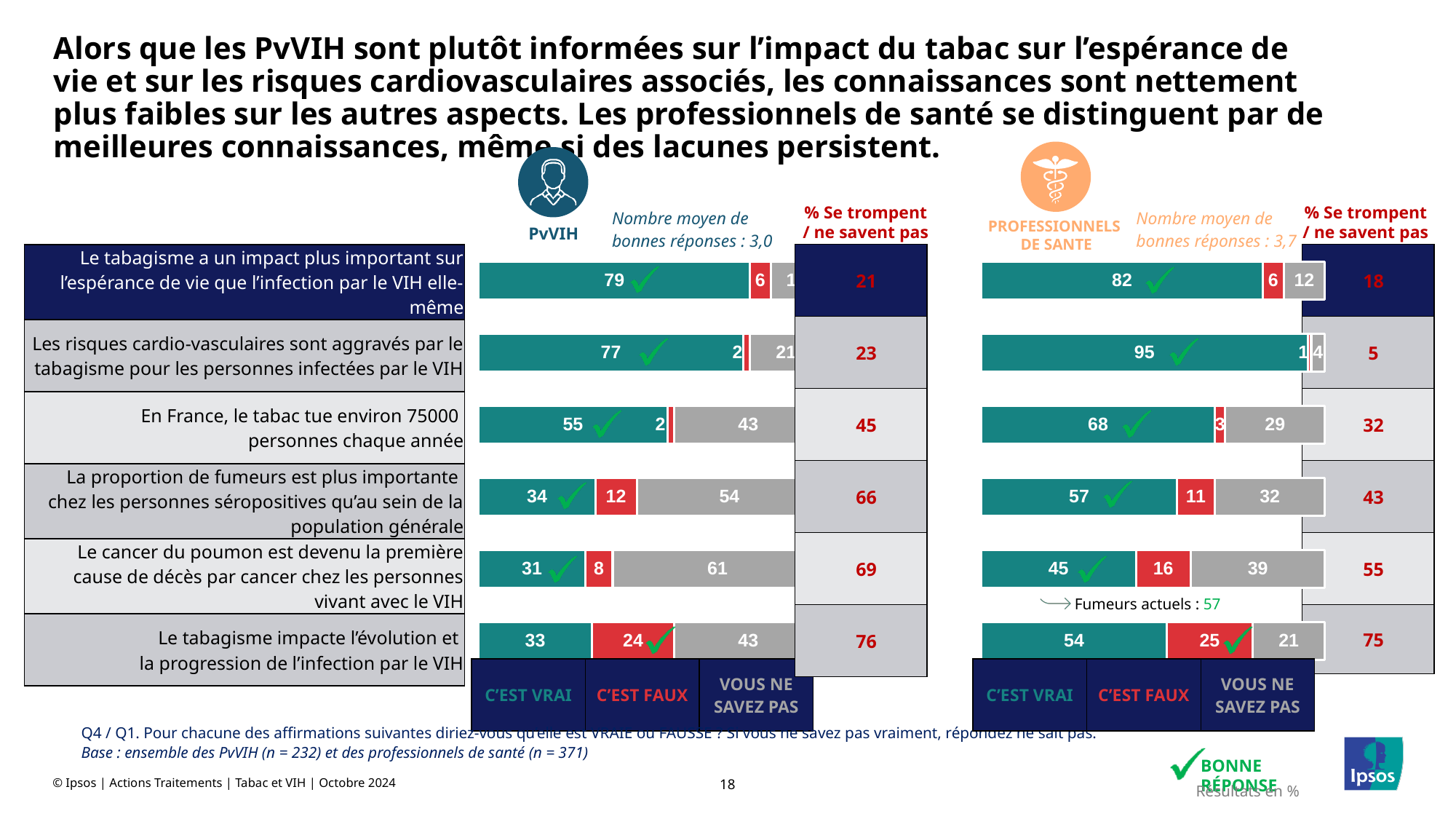
In the PvVIH chart, what is the total of the three segments for "La proportion de fumeurs est plus importante chez les personnes séropositives qu'au sein de la population générale"? 100 How many statements are shown in each chart? 6 What is the "Nombre moyen de bonnes réponses" for the Professionnels de santé? 3,7 What type of chart is used to show the responses? Stacked bar chart In the PvVIH chart, which statement has the lowest "C'est vrai" percentage? Le cancer du poumon est devenu la première cause de décès par cancer chez les personnes vivant avec le VIH How many response categories does the legend list for each chart? 3 What is the difference between the "C'est vrai" percentages for "La proportion de fumeurs est plus importante chez les personnes séropositives qu'au sein de la population générale" in the Professionnels de santé chart and in the PvVIH chart? 23 For "Le cancer du poumon est devenu la première cause de décès par cancer chez les personnes vivant avec le VIH", which group has the larger "Vous ne savez pas" percentage, PvVIH or Professionnels de santé? PvVIH In the PvVIH chart, what is the "% Se trompent / ne savent pas" value for "Le tabagisme impacte l'évolution et la progression de l'infection par le VIH"? 76 In the Professionnels de santé chart, what percentage answered "Vous ne savez pas" to "En France, le tabac tue environ 75000 personnes chaque année"? 29 In the PvVIH chart, what percentage answered "C'est vrai" to "Les risques cardio-vasculaires sont aggravés par le tabagisme pour les personnes infectées par le VIH"? 77 In the Professionnels de santé chart, which statement has the highest "C'est vrai" percentage? Les risques cardio-vasculaires sont aggravés par le tabagisme pour les personnes infectées par le VIH